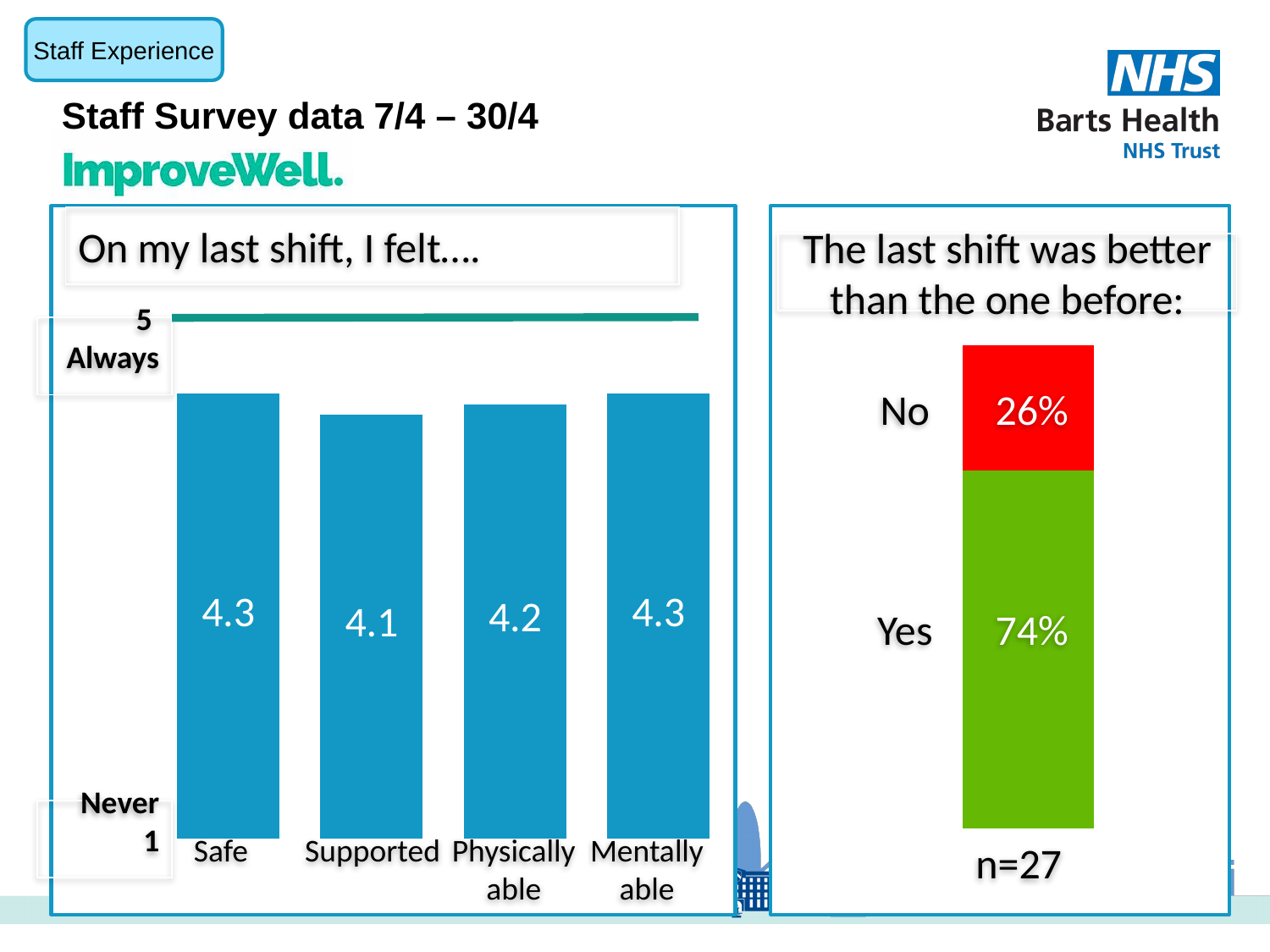
In the 'On my last shift, I felt….' chart, which is larger, the value for Physically able or the value for Supported? Physically able In the 'On my last shift, I felt….' chart, what is the value for Safe? 4.3 What kind of chart is the 'On my last shift, I felt….' chart? Bar chart In the 'On my last shift, I felt….' chart, what is the value for Supported? 4.1 In the 'On my last shift, I felt….' chart, how many categories are shown? 4 In the 'The last shift was better than the one before' chart, what colour is the Yes segment? Green In the 'The last shift was better than the one before' chart, what is the difference between the Yes and No percentages? 48% In the 'The last shift was better than the one before' chart, what percentage answered Yes? 74% In the 'On my last shift, I felt….' chart, what is the difference between the values for Safe and Supported? 0.2 In the 'On my last shift, I felt….' chart, which category has the lowest value? Supported In the 'On my last shift, I felt….' chart, what is the value for Physically able? 4.2 In the 'The last shift was better than the one before' chart, what percentage answered No? 26%